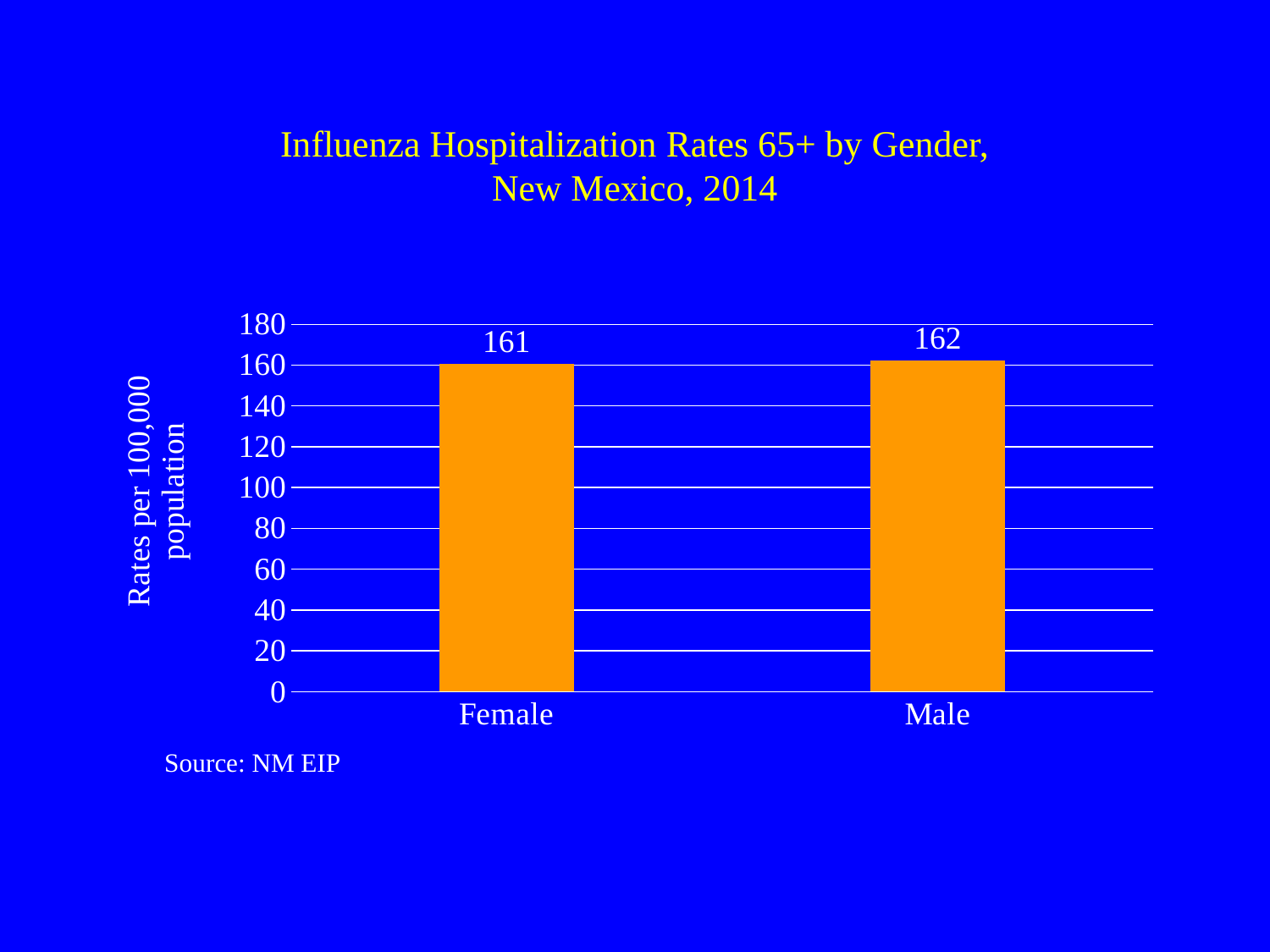
What kind of chart is shown on the slide? bar chart Which gender has the lower influenza hospitalization rate according to the data labels? Female What is the label of the y axis? Rates per 100,000 population What is the title of the chart? Influenza Hospitalization Rates 65+ by Gender, New Mexico, 2014 What is the difference between the Male and Female hospitalization rates? 1 What is the maximum value shown on the y axis? 180 How many categories are shown on the x axis? 2 Which gender has the higher influenza hospitalization rate according to the data labels? Male Is the value for Male greater or less than 180? less What is the influenza hospitalization rate for Female? 161 Is the value for Female greater or less than 140? greater What is the influenza hospitalization rate for Male? 162